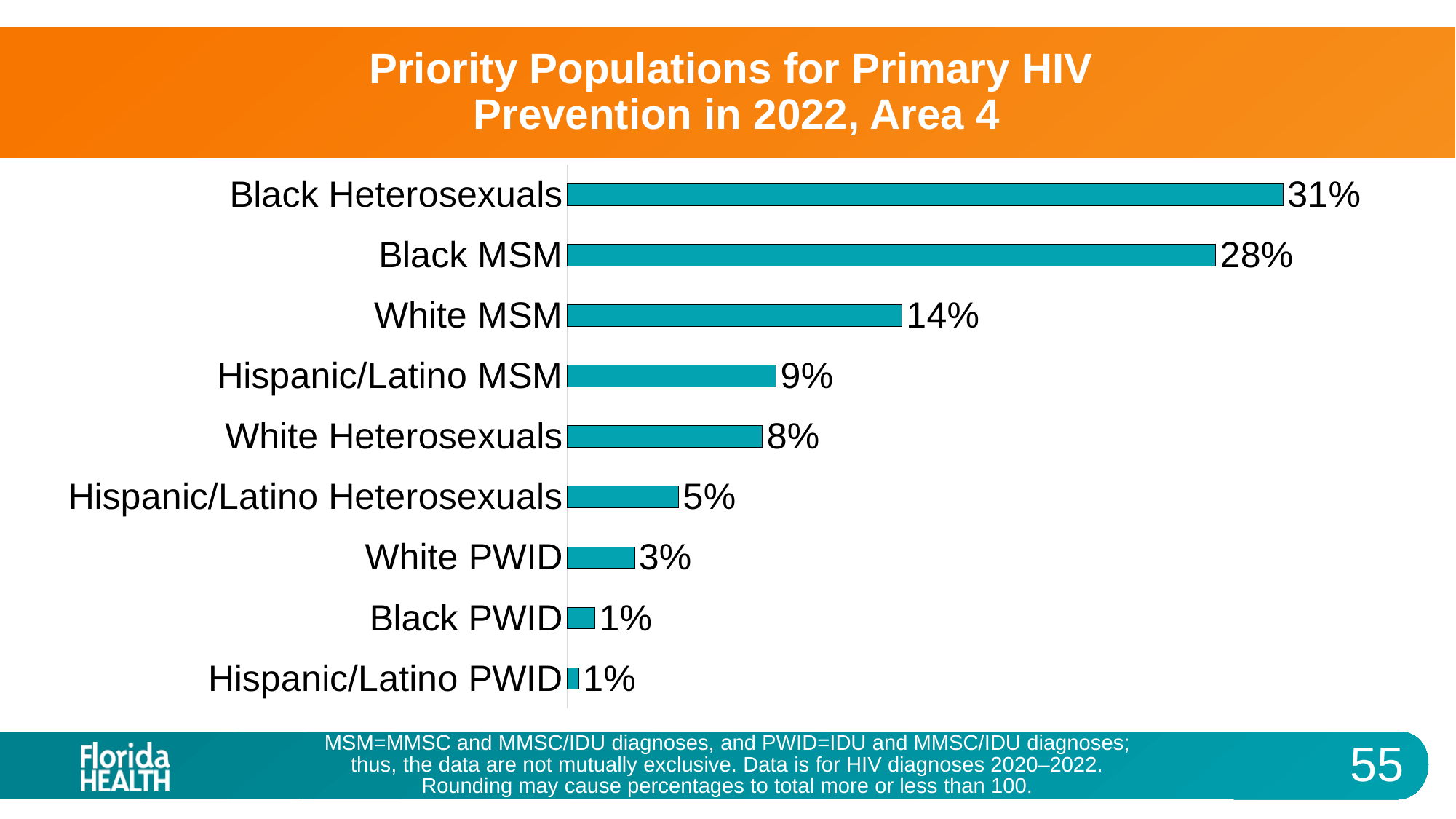
How many categories are shown in the chart? 9 What kind of chart is shown on the slide? Bar chart What is the title of the chart? Priority Populations for Primary HIV Prevention in 2022, Area 4 What is the difference between the values for Black Heterosexuals and Black MSM? 3% What is the value for Black Heterosexuals? 31% Which is larger, the value for White Heterosexuals or the value for Hispanic/Latino MSM? Hispanic/Latino MSM What is the value for White MSM? 14% What is the difference between the values for White MSM and Hispanic/Latino MSM? 5% What is the value for White PWID? 3% Which category has the highest value? Black Heterosexuals Which is larger, the value for Black MSM or the value for White MSM? Black MSM What is the value for Hispanic/Latino Heterosexuals? 5%